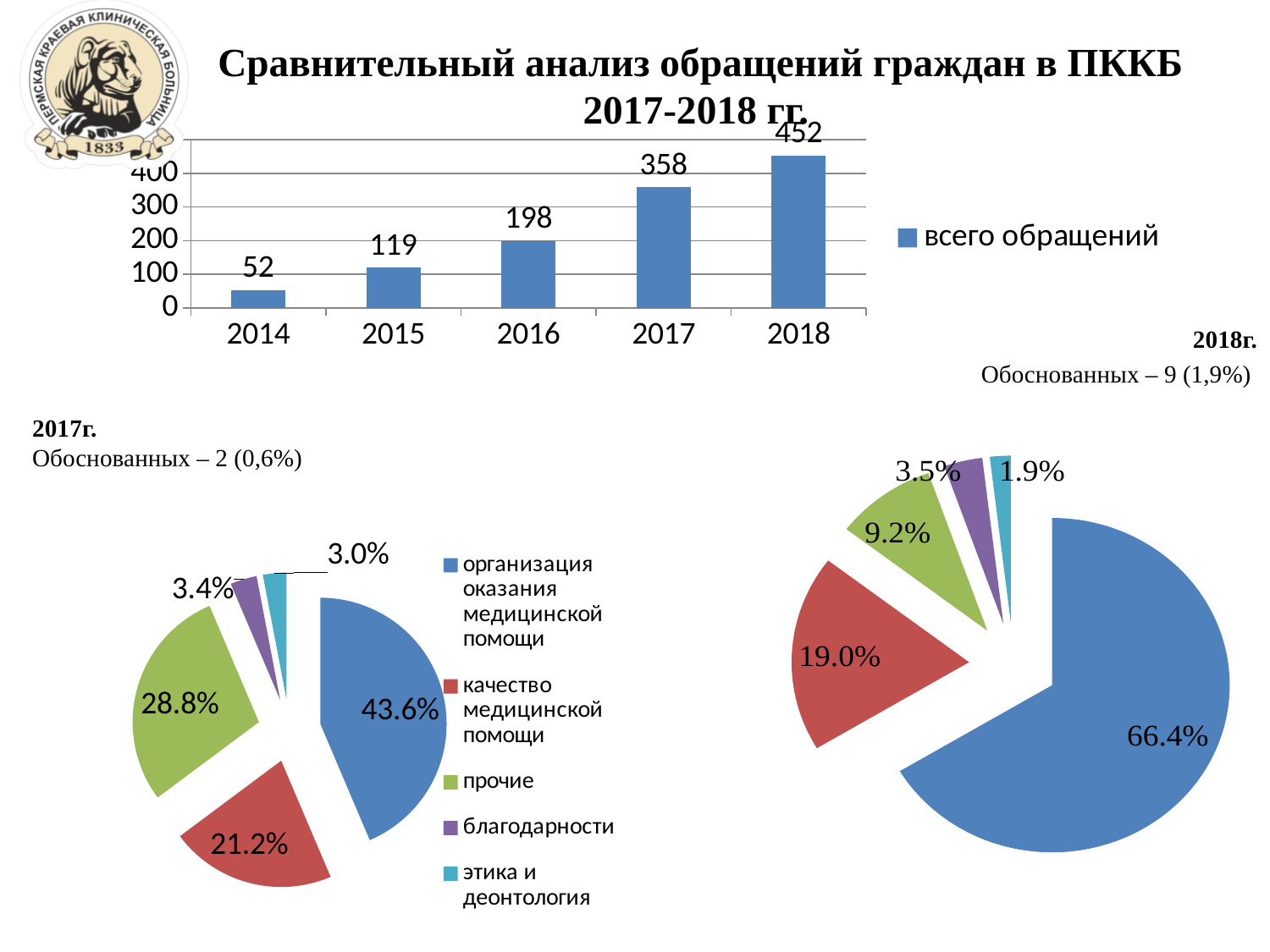
What type of chart is the top chart on the slide? bar chart How many categories does the legend of the pie charts list? 5 How many years are shown on the x axis of the top bar chart? 5 In the top bar chart, which year has the lowest value? 2014 In the top bar chart, do the values rise or fall from 2014 to 2018? rise In the top bar chart, what is the difference between the values for 2018 and 2017? 94 In the 2018 pie chart (bottom right), what is the share of the largest slice? 66.4% In the top bar chart, which year has the highest number of appeals (всего обращений)? 2018 In the 2018 pie chart (bottom right), which is larger: the 'качество медицинской помощи' slice or the 'прочие' slice? качество медицинской помощи In the 2017 pie chart (bottom left), what is the share of 'качество медицинской помощи'? 21.2% In the 2017 pie chart (bottom left), what share is labelled for the 'прочие' (green) slice? 28.8% In the top bar chart, what is the value for 2016? 198